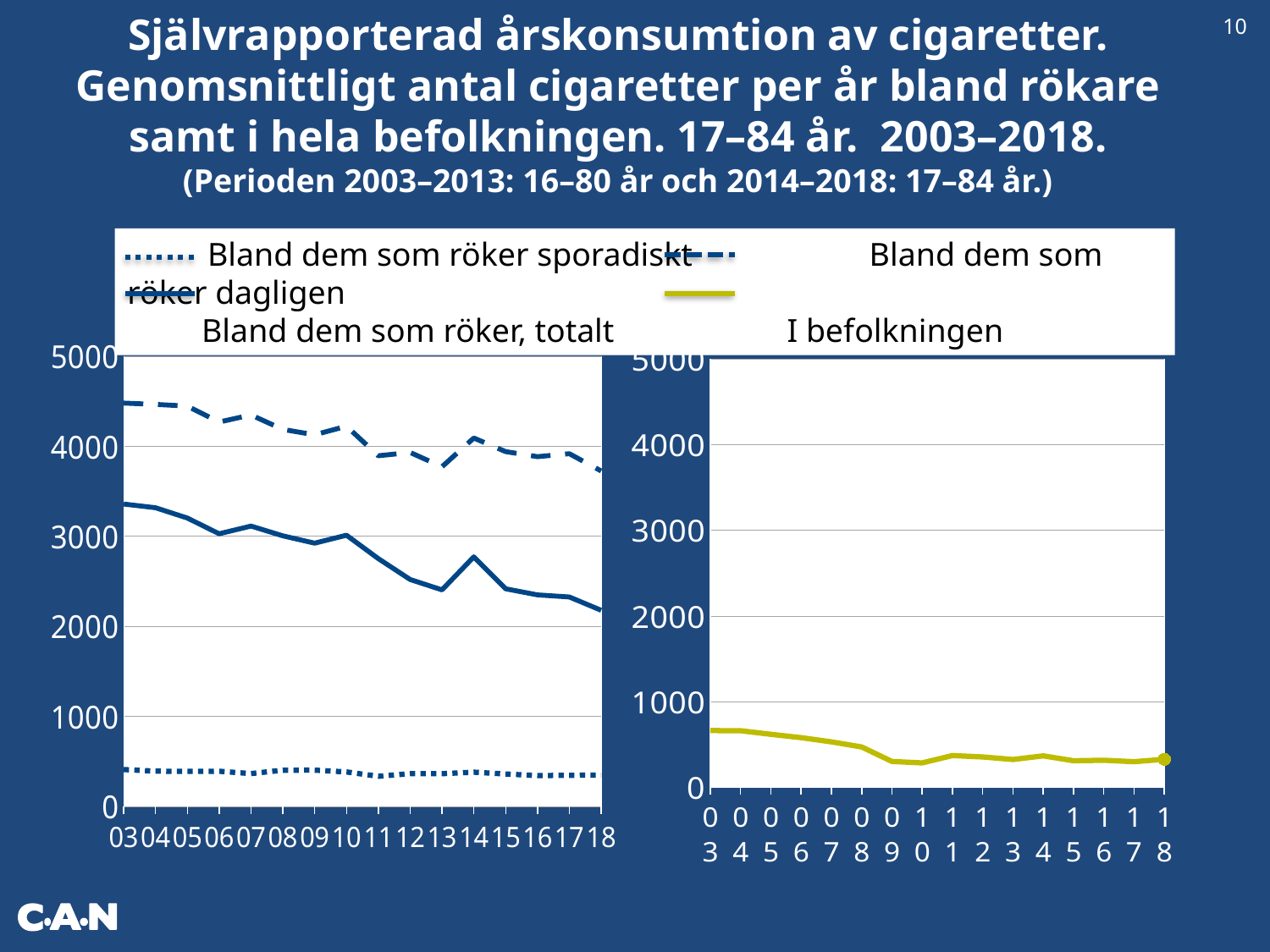
What kind of chart is the left chart on the slide? line chart How many years are plotted along the x axis of the left chart? 16 In the left chart, which series has the lowest values across the whole period? Bland dem som röker sporadiskt How many series does the legend list? 4 In the right chart, does the 'I befolkningen' series rise or fall from 2003 to 2018? fall In the left chart, is the value for 'Bland dem som röker dagligen' in 2003 greater or less than 4000? greater In the right chart 'I befolkningen', is the value for 2003 greater or less than 1000? less In the left chart, is the value for 'Bland dem som röker sporadiskt' in 2010 greater or less than 1000? less In the left chart, which series has the highest values across the whole period? Bland dem som röker dagligen In the left chart, which is larger in 2018: 'Bland dem som röker dagligen' or 'Bland dem som röker, totalt'? Bland dem som röker dagligen In the left chart, does the 'Bland dem som röker, totalt' series rise or fall from 2003 to 2018? fall